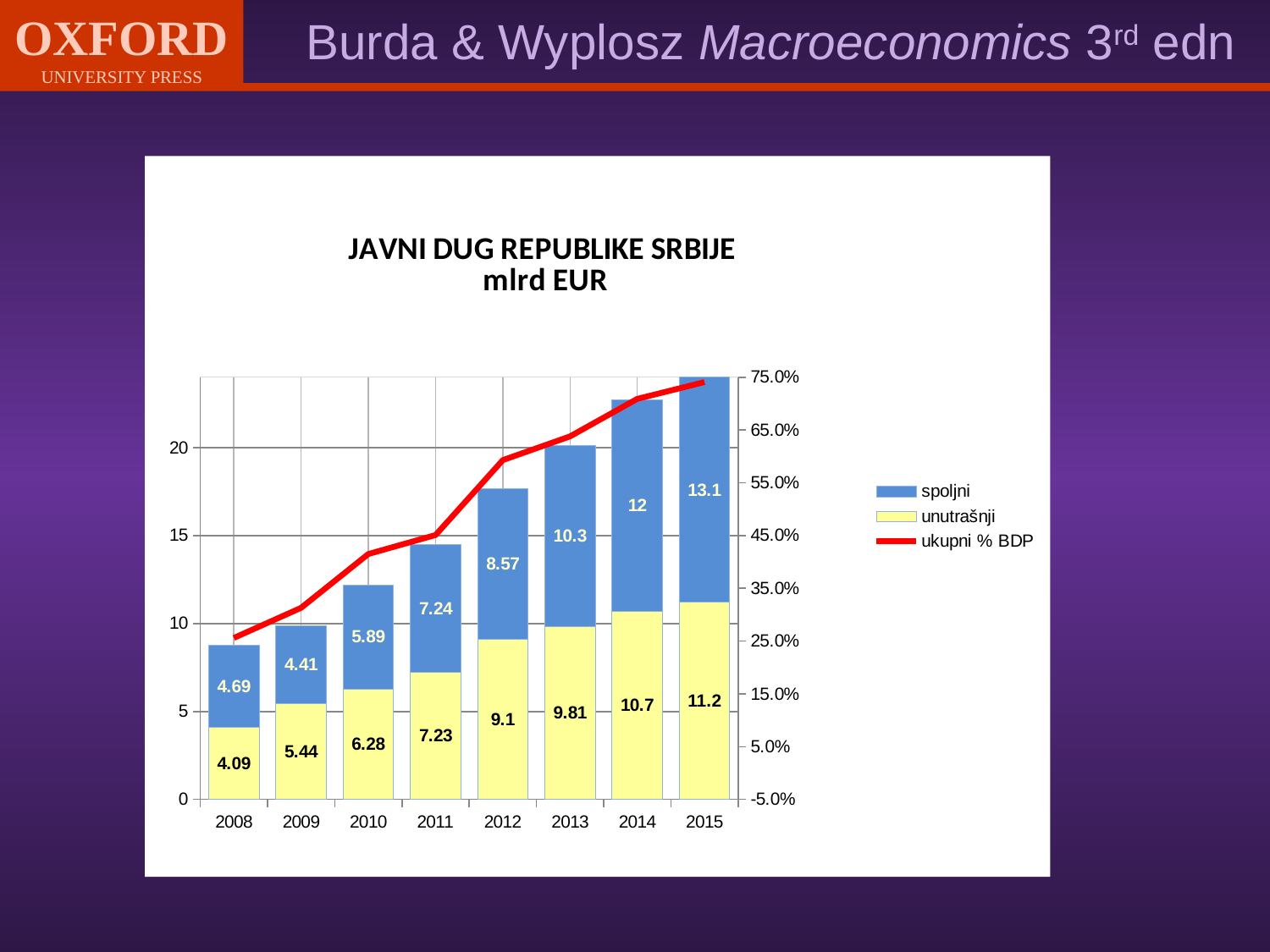
Which year has the highest spoljni value? 2015 What is the value of spoljni for 2012? 8.57 Which is larger in 2011, spoljni or unutrašnji? spoljni What is the value of unutrašnji for 2008? 4.09 How many series does the legend list? 3 Which year has the lowest unutrašnji value? 2008 Is the ukupni % BDP value for 2015 greater or less than 65.0%? greater What is the total of the stacked bar for 2015? 24.3 How many years are shown on the x axis? 8 What is the value of spoljni for 2015? 13.1 What is the difference between the unutrašnji values for 2015 and 2014? 0.5 Does the ukupni % BDP line rise or fall from 2008 to 2015? rise